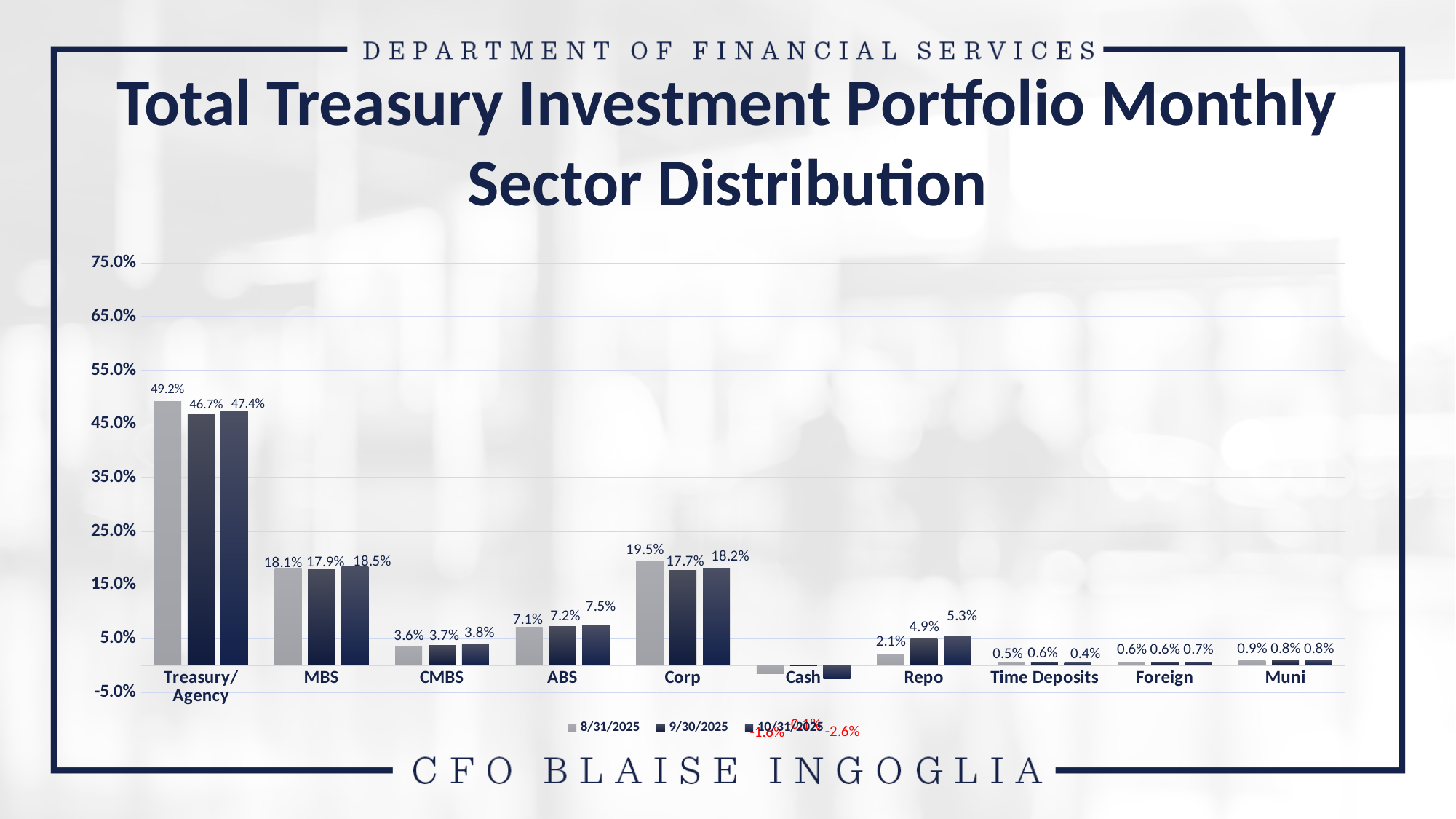
How many sector categories are shown on the x axis? 10 What is the difference between the Treasury/Agency values for 8/31/2025 and 9/30/2025? 2.5% Do the Repo values rise or fall from 8/31/2025 to 10/31/2025? rise Which is larger for 10/31/2025: MBS or Corp? MBS What kind of chart is shown on the slide? bar chart What is the value for Repo for 10/31/2025? 5.3% Which sector has the highest value for 10/31/2025? Treasury/Agency How many series does the legend list? 3 What is the value for Corp for 9/30/2025? 17.7% What is the title of the chart? Total Treasury Investment Portfolio Monthly Sector Distribution Is the value for Treasury/Agency for 9/30/2025 greater or less than 45.0%? greater What is the value for Treasury/Agency for 8/31/2025? 49.2%